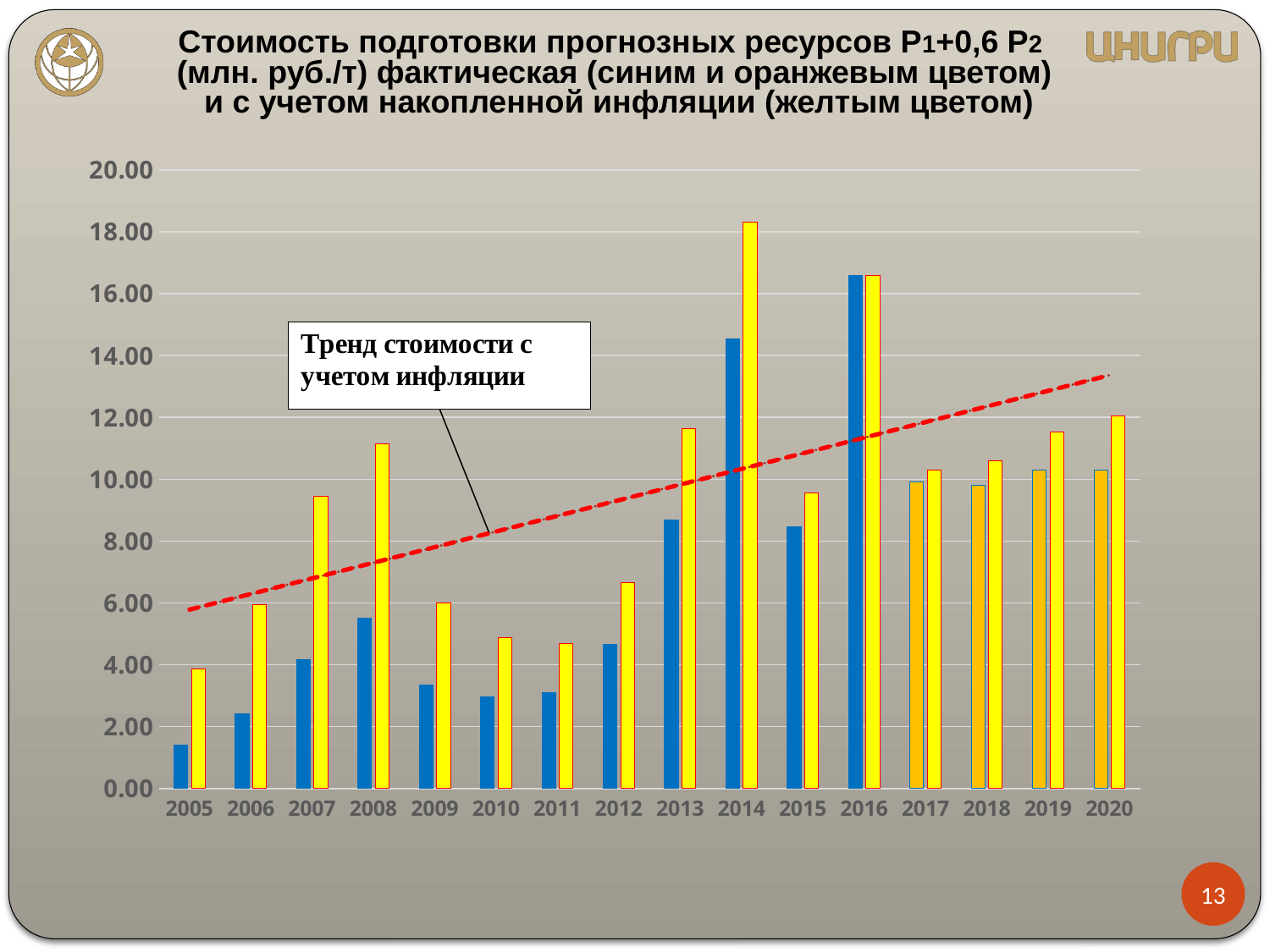
In which year is the blue (actual) bar the lowest? 2005 Is the yellow bar for 2007 greater or less than 8.00? greater How many years are shown along the x axis of the chart? 16 Is the blue bar for 2010 greater or less than 4.00? less Is the blue bar for 2005 greater or less than 2.00? less In which year is the blue (actual) bar the highest? 2016 In which year is the yellow (inflation-adjusted) bar the highest? 2014 What does the text box annotation on the chart say? Тренд стоимости с учетом инфляции Which is larger: the blue bar for 2007 or the blue bar for 2008? 2008 What kind of chart is shown on the slide? bar chart Does the red dashed trend line rise or fall from 2005 to 2020? rises